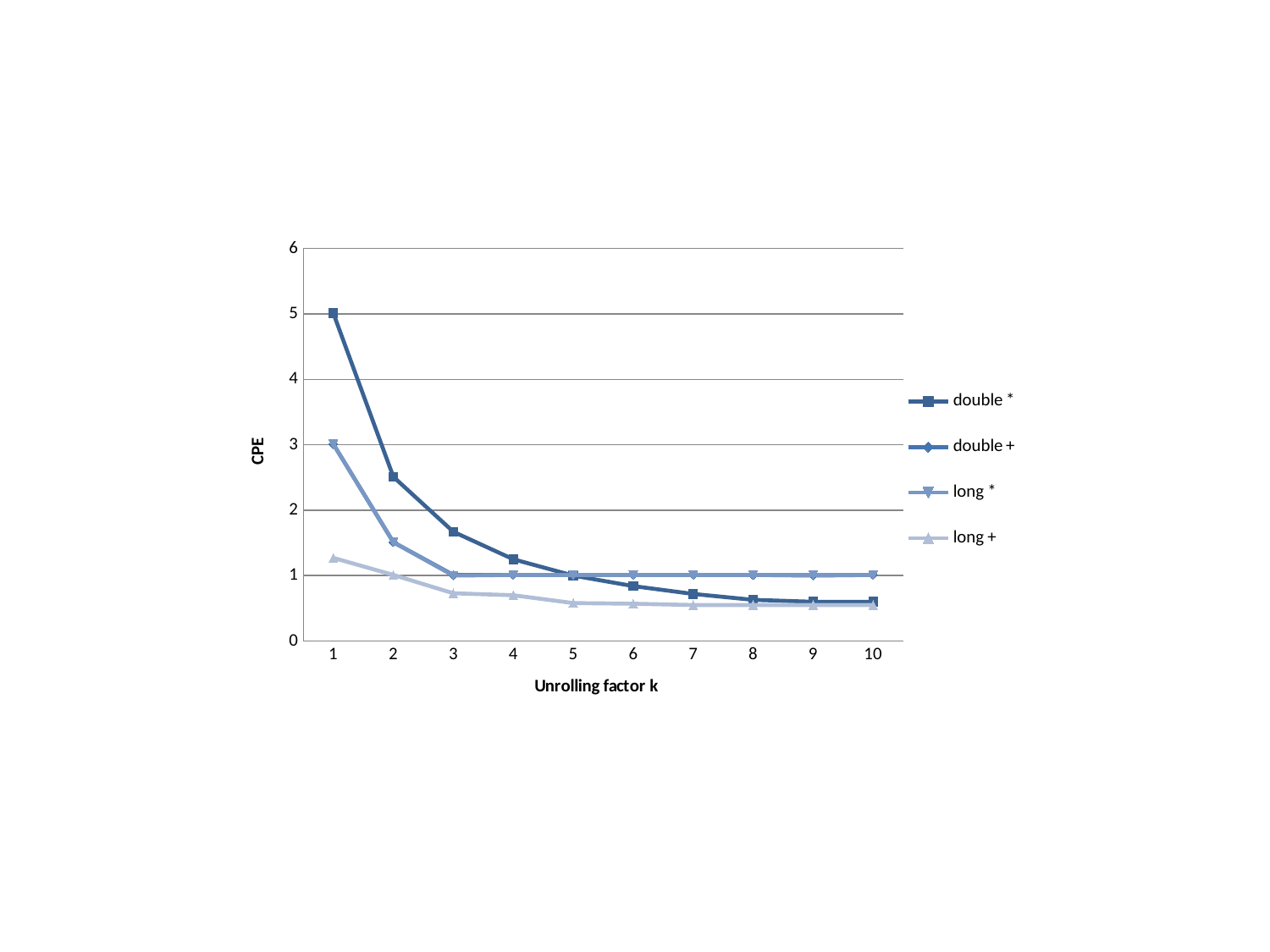
What kind of chart is shown on the slide? line chart Which series has the lowest CPE at unrolling factor 1? long + How many unrolling factor values are plotted along the x axis? 10 What is the CPE for the long * series at unrolling factor 5? 1 What is the label of the x axis? Unrolling factor k What is the CPE for the double * series at unrolling factor 1? 5 Which series has the highest CPE at unrolling factor 1? double * Does the CPE for the double * series rise or fall as the unrolling factor increases? fall Is the CPE for long + at unrolling factor 5 greater or less than 1? less What is the CPE for the long * series at unrolling factor 1? 3 How many series does the legend list? 4 Is the CPE for double * at unrolling factor 2 greater or less than 2? greater